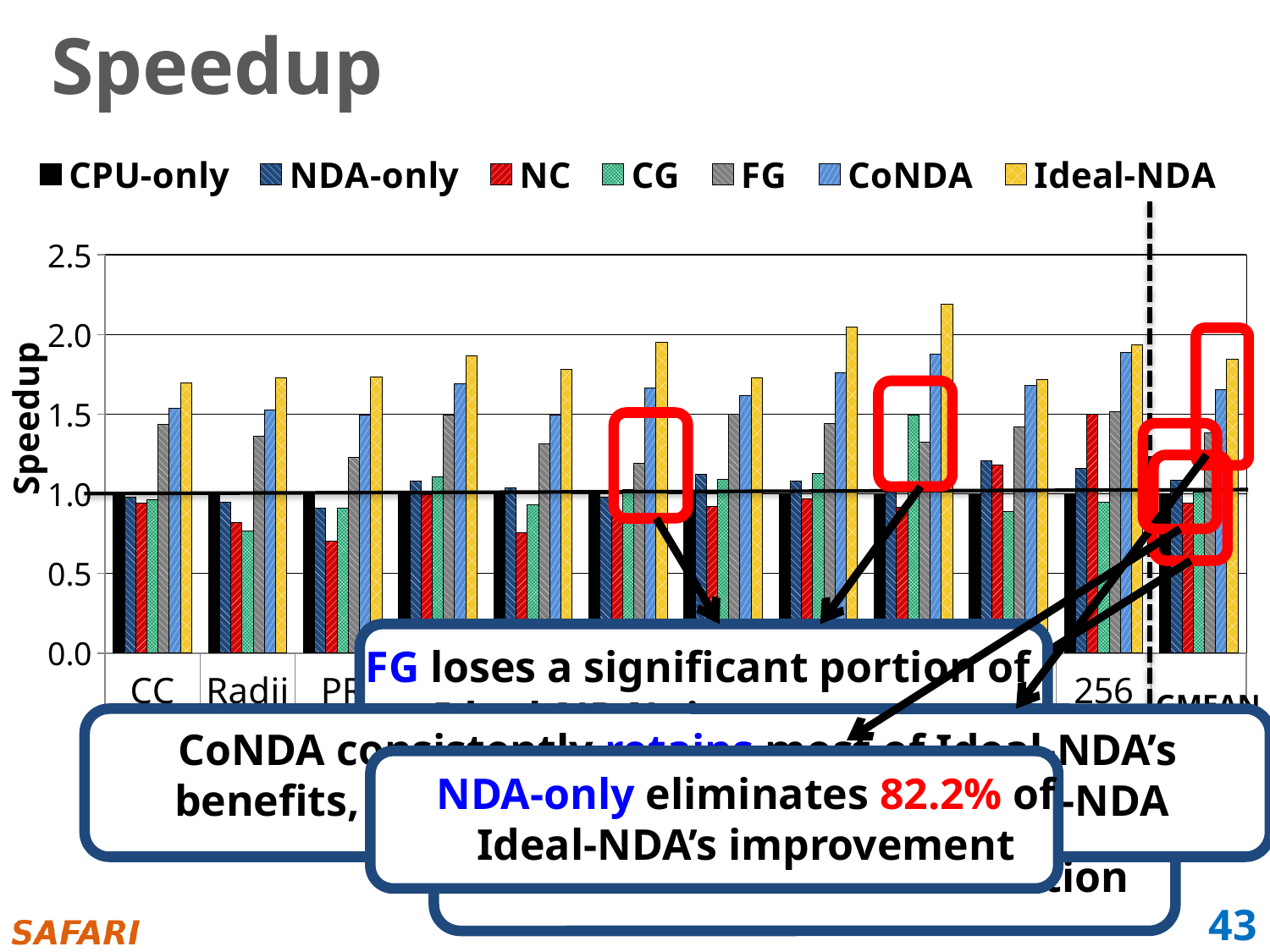
Is the NC value for Radii greater or less than 1.0? less For the CC category, which series has the highest speedup? Ideal-NDA What is the label on the vertical axis of the chart? Speedup For the GMEAN category, which is larger: the CoNDA value or the NC value? CoNDA How many series does the legend list? 7 For the CC category, which is larger: the CoNDA value or the Ideal-NDA value? Ideal-NDA Is the FG value for Radii greater or less than 1.0? greater What kind of chart is shown on the slide? bar chart Is the Ideal-NDA value for GMEAN greater or less than 1.5? greater For the Radii category, which series has the highest speedup? Ideal-NDA Which series is listed first in the legend? CPU-only